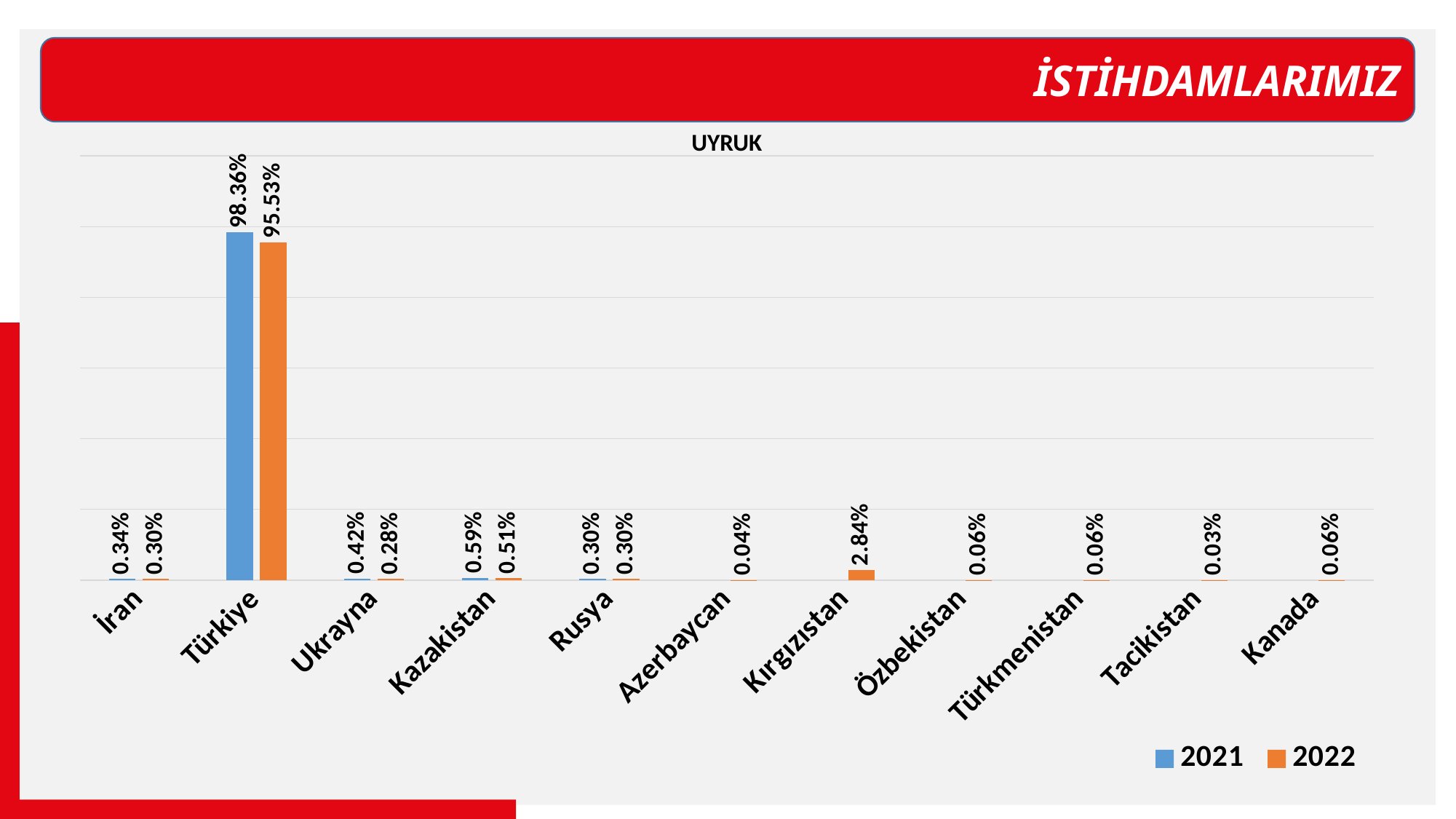
What is the value for Ukrayna in 2022? 0.28% What is the value for Türkiye in 2021? 98.36% What is the difference between the 2021 and 2022 values for Türkiye? 2.83 percentage points What is the value for Türkiye in 2022? 95.53% What is the value for Kırgızistan in 2022? 2.84% What is the title of the chart? UYRUK Which category has the highest value in 2022? Türkiye What is the value for Rusya in 2021? 0.30% How many categories are shown on the x axis? 11 How many series does the legend list? 2 Which is larger for 2021: İran or Ukrayna? Ukrayna What is the value for Kazakistan in 2021? 0.59%